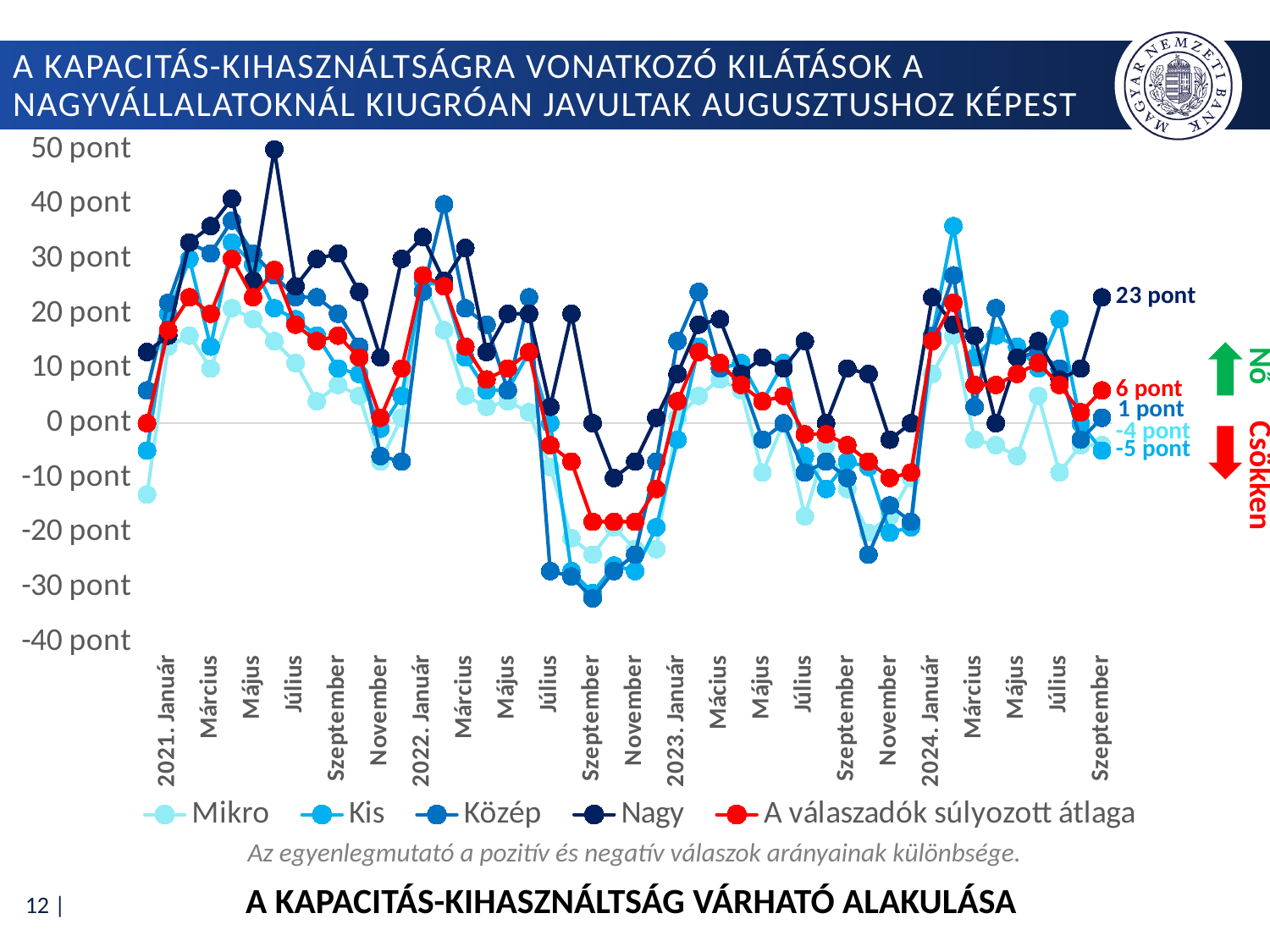
What kind of chart is shown on the slide? line chart Does the Nagy series rise or fall between the last two points of the chart? rise At the last point (Szeptember 2024), which is larger: the Nagy value or the Közép value? Nagy What is the highest value shown on the vertical axis? 50 pont At the last point (Szeptember 2024), how much higher is the Nagy series than 'A válaszadók súlyozott átlaga'? 17 pont What is the value of the Nagy series at the last point (Szeptember 2024)? 23 pont How many series does the legend list? 5 Which series is drawn in red? A válaszadók súlyozott átlaga What is the value of 'A válaszadók súlyozott átlaga' at the last point (Szeptember 2024)? 6 pont Which series has the highest value at the last point (Szeptember 2024)? Nagy What is the value of the Közép series at the last point (Szeptember 2024)? 1 pont